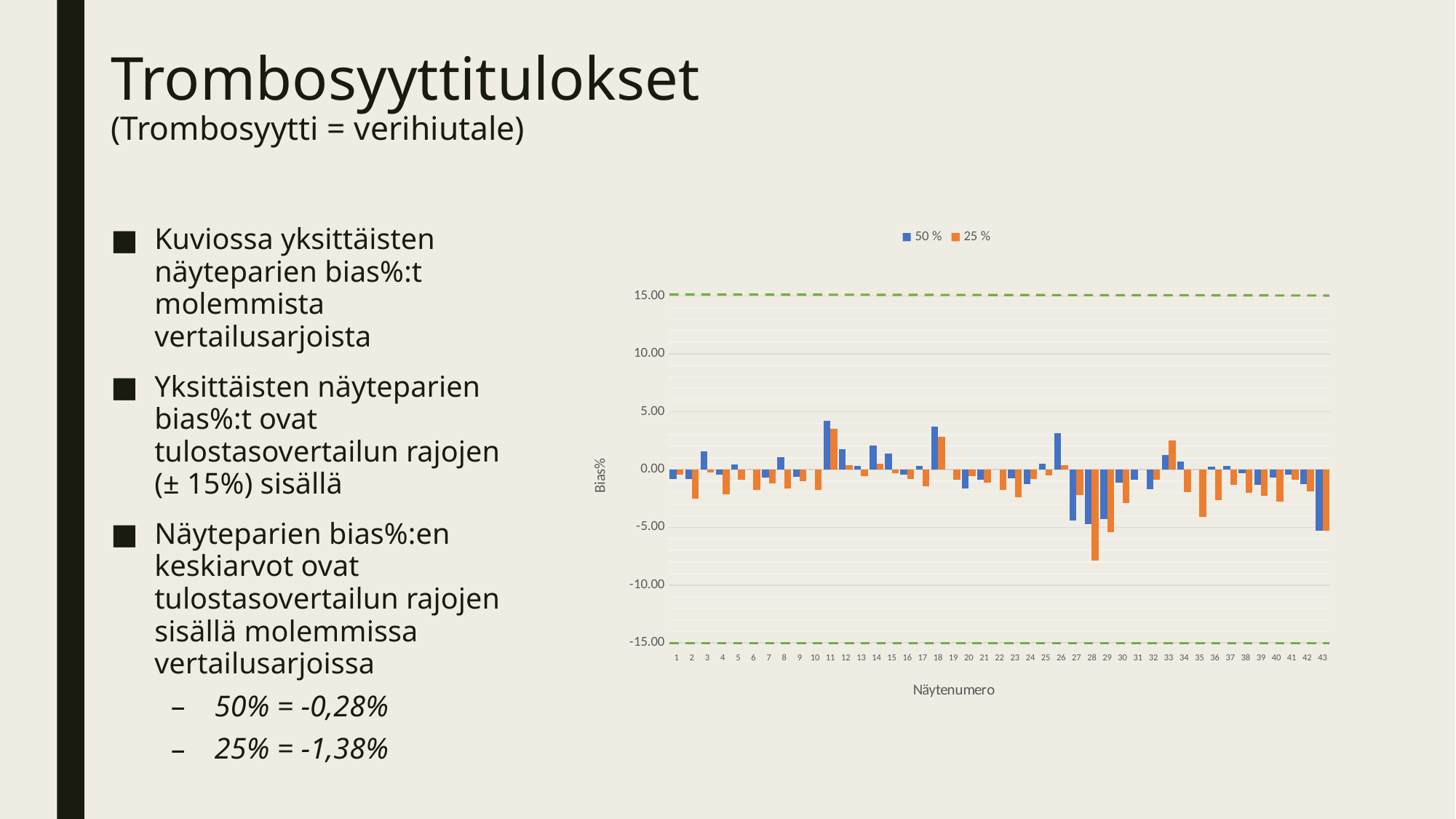
Is the value for sample 26 in the 50 % series greater or less than 5.00? less How many series does the chart legend list? 2 How many sample numbers (Näytenumero) are plotted on the x axis? 43 What kind of chart is shown on the slide? bar chart Is the value for sample 11 in the 50 % series greater or less than 0.00? greater For sample 28, which series has the larger value, 50 % or 25 %? 50 % Which sample number has the lowest value for the 25 % series? 28 Is the value for sample 43 in the 50 % series greater or less than 0.00? less What are the two series named in the chart legend? 50 % and 25 % In the 50 % series, which is larger: the value for sample 11 or the value for sample 28? sample 11 What is the title of the chart's y axis? Bias%